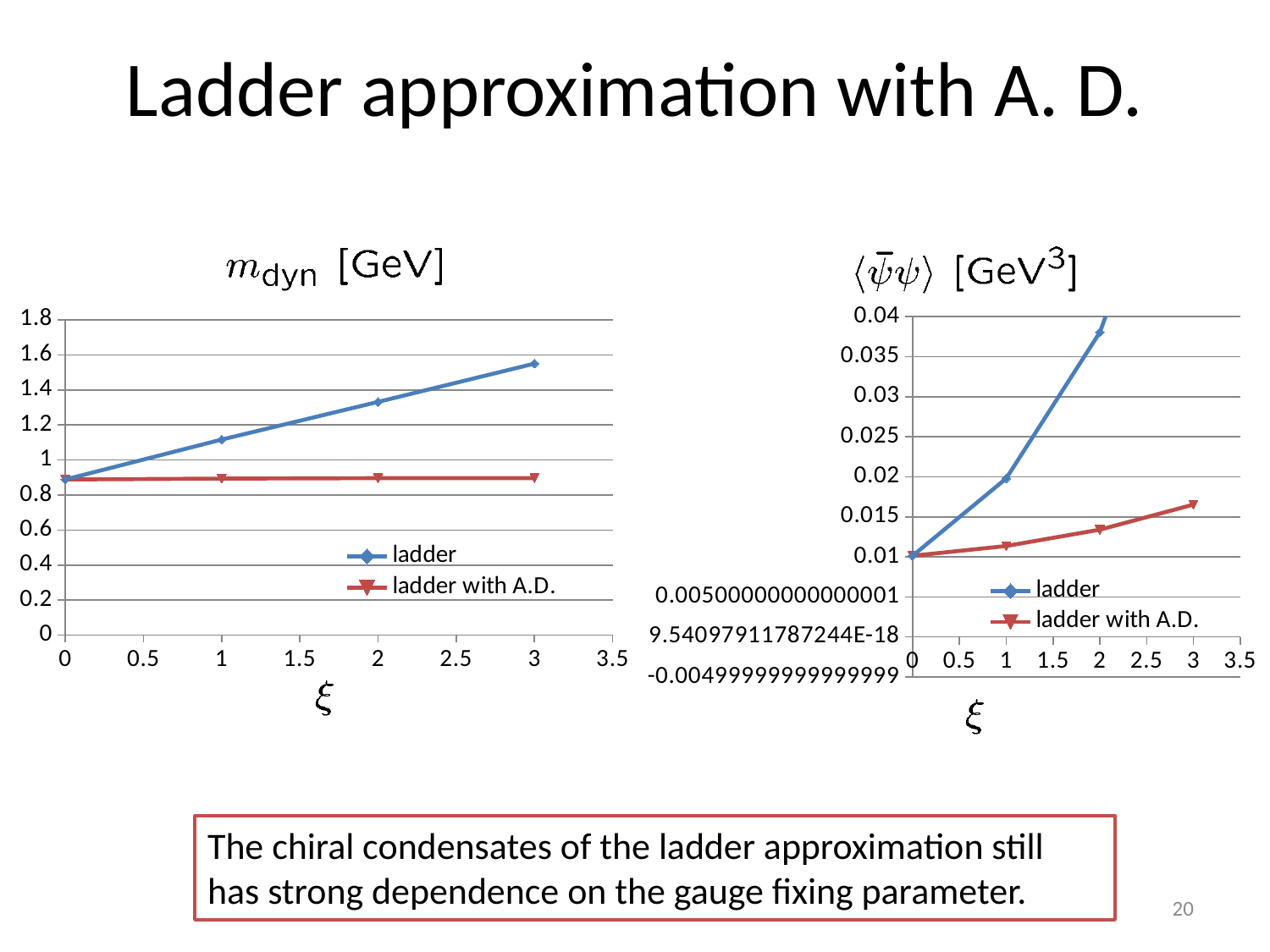
In the right chart (chiral condensate [GeV^3]), what are the two legend entries? ladder; ladder with A.D. In the left chart (m_dyn [GeV]), does the 'ladder' series rise or fall as ξ increases? rise In the left chart (m_dyn [GeV]), at ξ = 2, which series has the larger value, 'ladder' or 'ladder with A.D.'? ladder In the left chart (m_dyn [GeV]), what kind of chart is shown? line chart In the right chart (chiral condensate [GeV^3]), what kind of chart is shown? line chart In the left chart (m_dyn [GeV]), how many data points does the 'ladder' series have? 4 In the right chart (chiral condensate [GeV^3]), is the value of the 'ladder' series at ξ = 2 greater or less than 0.03? greater In the left chart (m_dyn [GeV]), is the value of the 'ladder' series at ξ = 3 greater or less than 1.4? greater In the left chart (m_dyn [GeV]), how many series does the legend list? 2 In the left chart (m_dyn [GeV]), is the value of the 'ladder with A.D.' series at ξ = 3 greater or less than 1? less In the right chart (chiral condensate [GeV^3]), how many series does the legend list? 2